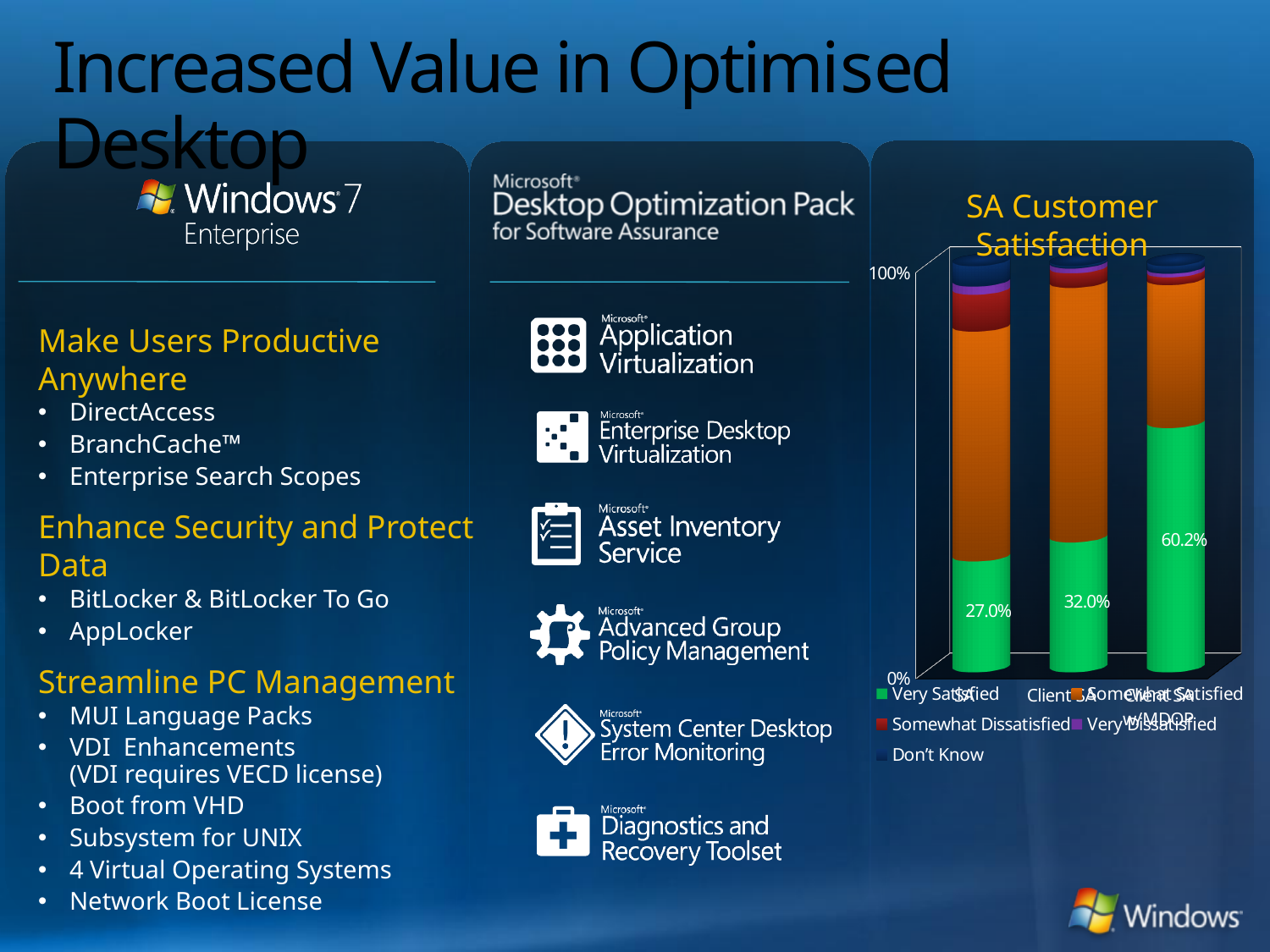
Which category has the lowest Very Satisfied share in the SA Customer Satisfaction chart? SA How many series does the legend of the SA Customer Satisfaction chart list? 5 What is the Very Satisfied value for Client SA in the SA Customer Satisfaction chart? 32.0% In the SA Customer Satisfaction chart, which has the larger Very Satisfied share: SA or Client SA? Client SA Which category has the highest Very Satisfied share in the SA Customer Satisfaction chart? Client SA w/MDOP In the SA Customer Satisfaction chart, how much higher is the Very Satisfied share for Client SA w/MDOP than for SA? 33.2% How many categories (bars) are shown in the SA Customer Satisfaction chart? 3 What is the Very Satisfied value for Client SA w/MDOP in the SA Customer Satisfaction chart? 60.2% What is the Very Satisfied value for SA in the SA Customer Satisfaction chart? 27.0% Does the Very Satisfied share rise or fall from left to right across the categories in the SA Customer Satisfaction chart? Rise What kind of chart is the SA Customer Satisfaction chart? Stacked bar chart In the SA Customer Satisfaction chart, what is the difference between the Very Satisfied shares for Client SA and SA? 5.0%